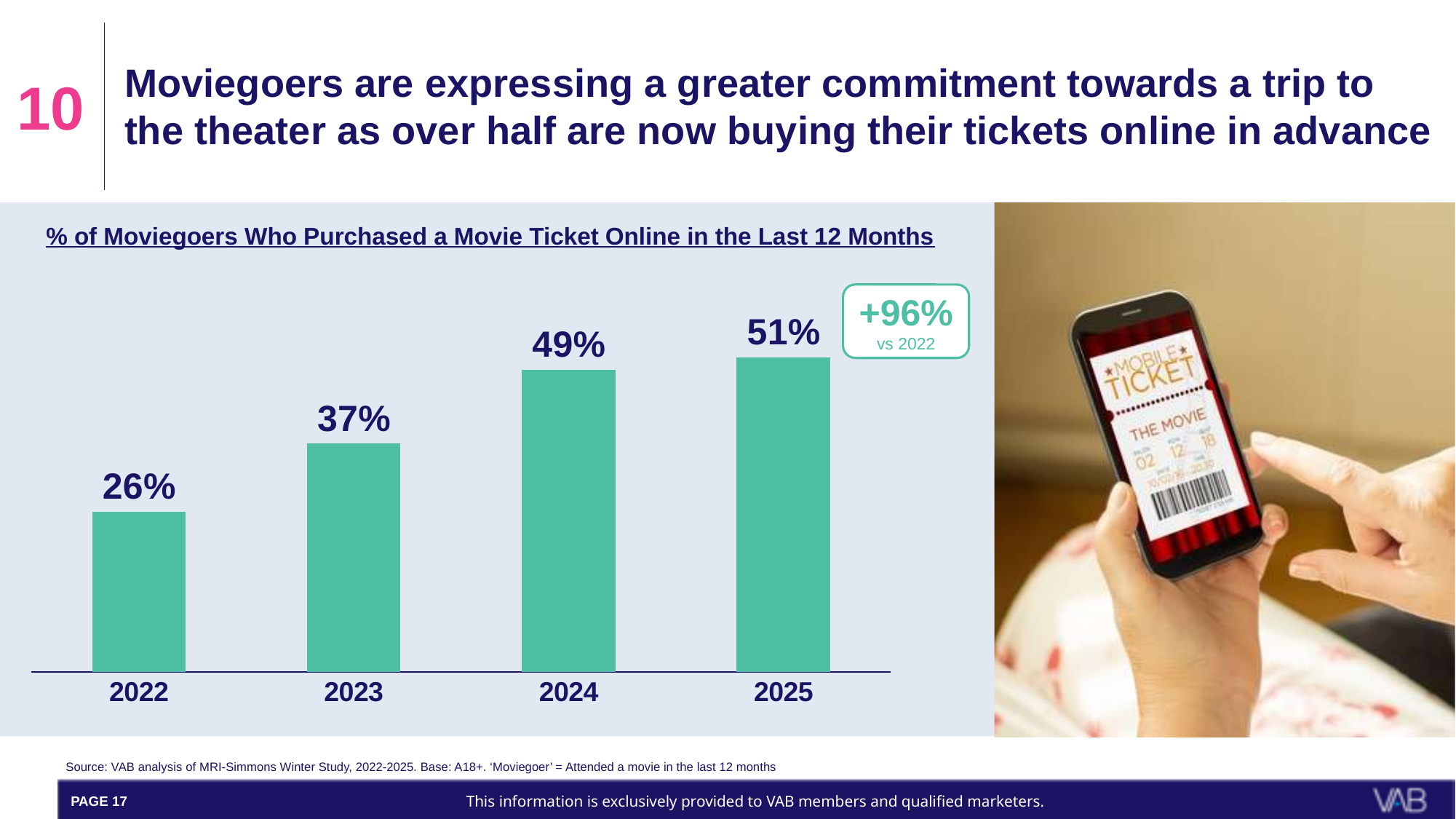
What is the difference in percentage points between 2023 and 2022? 11 What is the value shown for 2024? 49% What is the difference in percentage points between 2025 and 2022? 25 What kind of chart is shown on the slide? Bar chart What percentage of moviegoers purchased a movie ticket online in 2022? 26% What is the value shown for 2025? 51% Which year has the lowest percentage of moviegoers purchasing tickets online? 2022 How many years are shown on the chart? 4 Which year has the highest percentage of moviegoers purchasing tickets online? 2025 What percentage change vs 2022 is shown in the callout box next to the 2025 bar? +96% Which year has a larger value, 2023 or 2024? 2024 Do the values rise or fall from 2022 to 2025? Rise